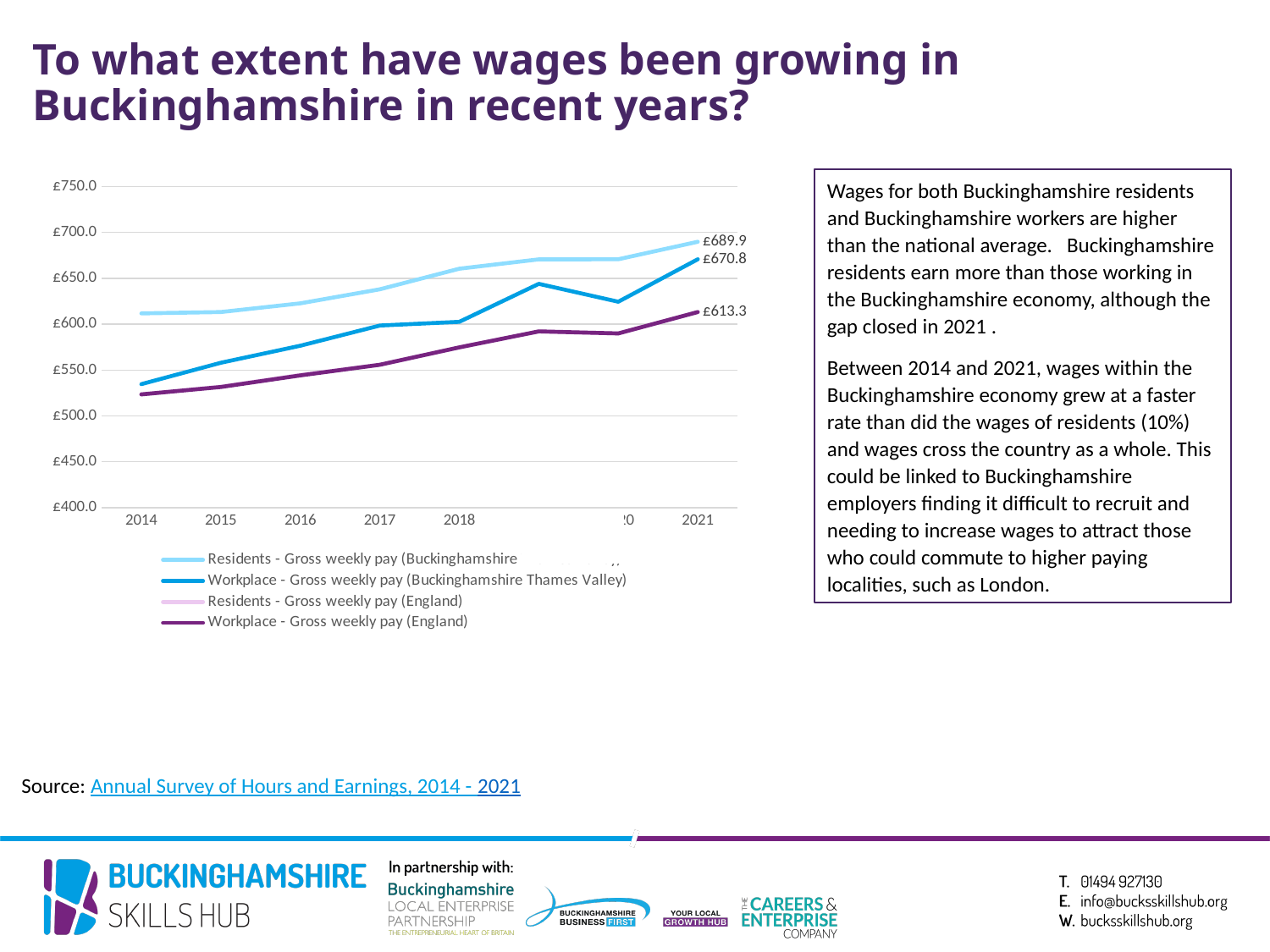
Is the 2014 value for Residents - Gross weekly pay (Buckinghamshire) greater or less than £600.0? greater In 2021, which is larger: Workplace - Gross weekly pay (Buckinghamshire Thames Valley) or Workplace - Gross weekly pay (England)? Workplace - Gross weekly pay (Buckinghamshire Thames Valley) In 2021, how much higher is Residents - Gross weekly pay (Buckinghamshire) than Workplace - Gross weekly pay (England)? £76.6 What is the 2021 value for Residents - Gross weekly pay (Buckinghamshire)? £689.9 How many series does the chart's legend list? 4 In 2021, what is the difference between Residents - Gross weekly pay (Buckinghamshire) and Workplace - Gross weekly pay (Buckinghamshire Thames Valley)? £19.1 Which series has the highest value in 2021? Residents - Gross weekly pay (Buckinghamshire) What is the 2021 value for Workplace - Gross weekly pay (England)? £613.3 What is the 2021 value for Workplace - Gross weekly pay (Buckinghamshire Thames Valley)? £670.8 Does the Residents - Gross weekly pay (Buckinghamshire) line rise or fall from 2014 to 2021? rise Is the 2014 value for Workplace - Gross weekly pay (England) greater or less than £550.0? less What kind of chart is shown on the slide? line chart